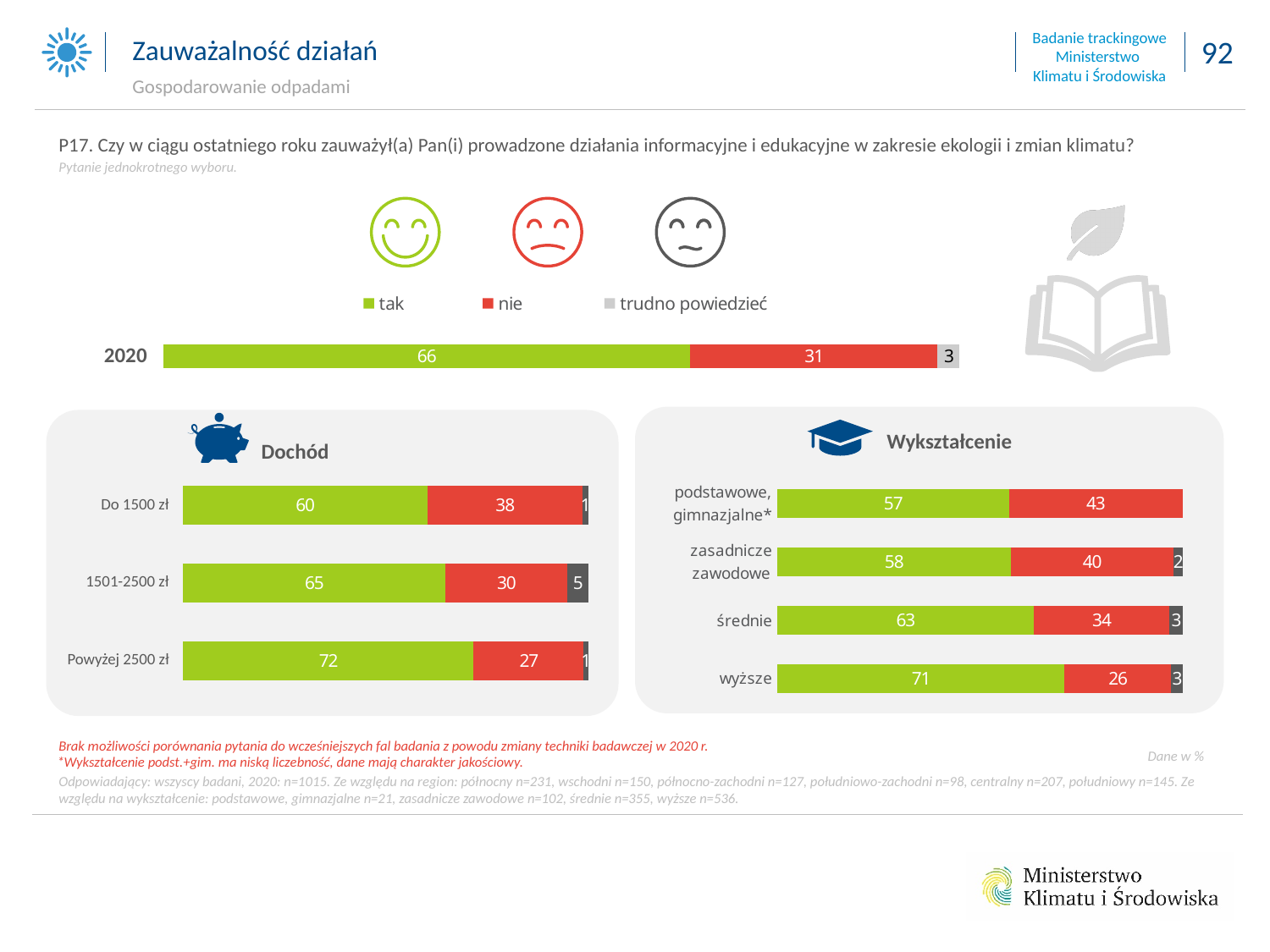
In the top 2020 bar chart, what is the difference between the "tak" and "nie" values? 35 In the top 2020 bar chart, what percentage answered "nie"? 31 How many series does the legend above the 2020 bar list? 3 In the Dochód chart, what is the "tak" value for Powyżej 2500 zł? 72 In the Dochód chart, what is the "trudno powiedzieć" value for 1501-2500 zł? 5 What type of chart is the Wykształcenie chart? Stacked horizontal bar chart In the Dochód chart, which income group has the highest "tak" value? Powyżej 2500 zł In the Wykształcenie chart, is the "tak" value larger for średnie or for wyższe? wyższe In the Wykształcenie chart, which education group has the lowest "tak" value? podstawowe, gimnazjalne* In the Dochód chart, how many income categories are shown? 3 In the top 2020 bar chart, what percentage answered "tak"? 66 In the Wykształcenie chart, what is the "nie" value for podstawowe, gimnazjalne*? 43